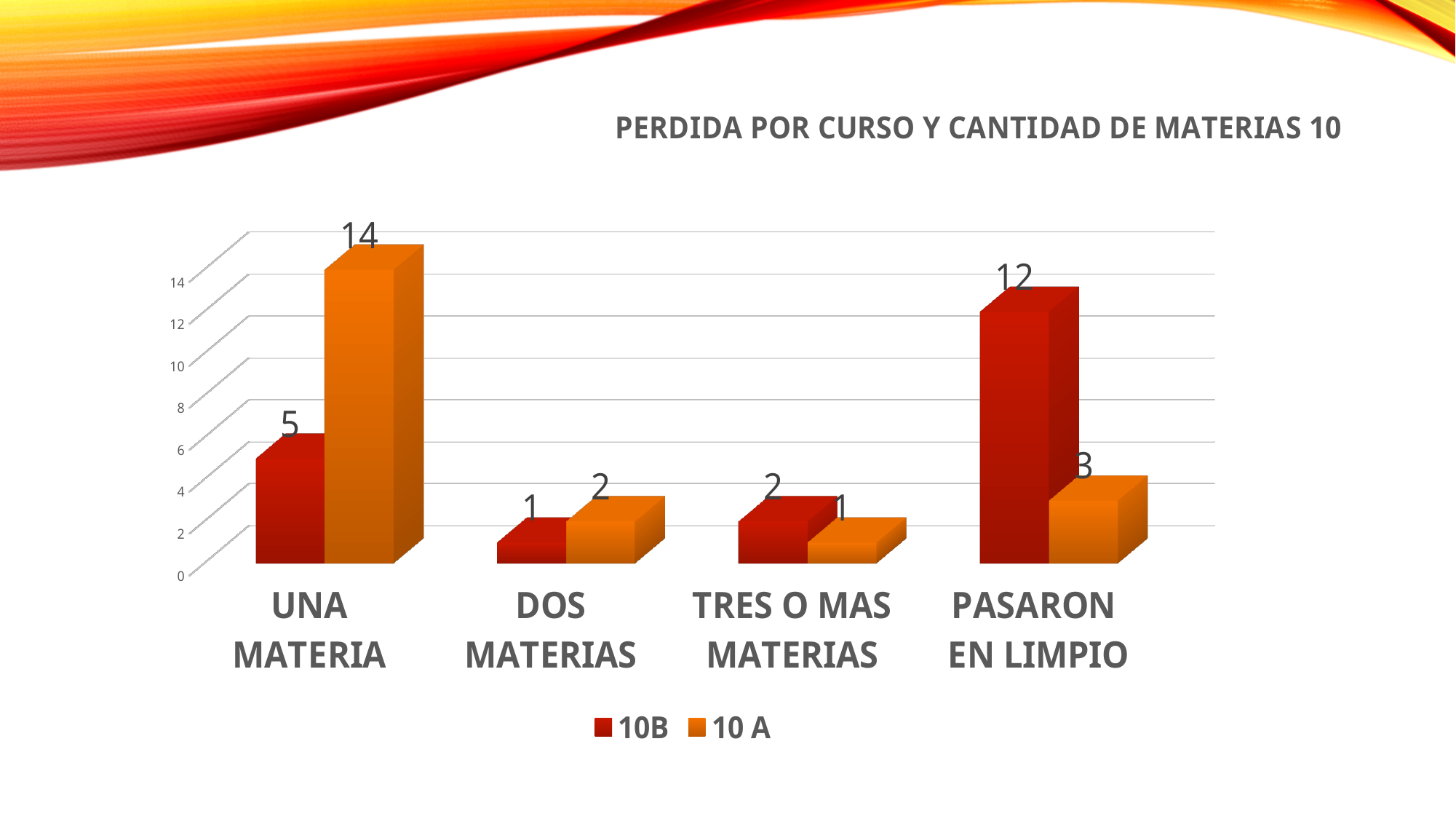
In the PASARON EN LIMPIO category, which series has the larger value, 10B or 10 A? 10B What is the value for 10 A in the TRES O MAS MATERIAS category? 1 Which category has the highest value for the 10 A series? UNA MATERIA How many series does the legend list? 2 How many categories are shown on the x axis? 4 What is the title of the chart? PERDIDA POR CURSO Y CANTIDAD DE MATERIAS 10 What is the value for 10B in the PASARON EN LIMPIO category? 12 What is the value for 10 A in the UNA MATERIA category? 14 Which category has the lowest value for the 10B series? DOS MATERIAS What is the value for 10B in the UNA MATERIA category? 5 What is the difference between the 10 A and 10B values in the UNA MATERIA category? 9 What kind of chart is shown on the slide? Bar chart